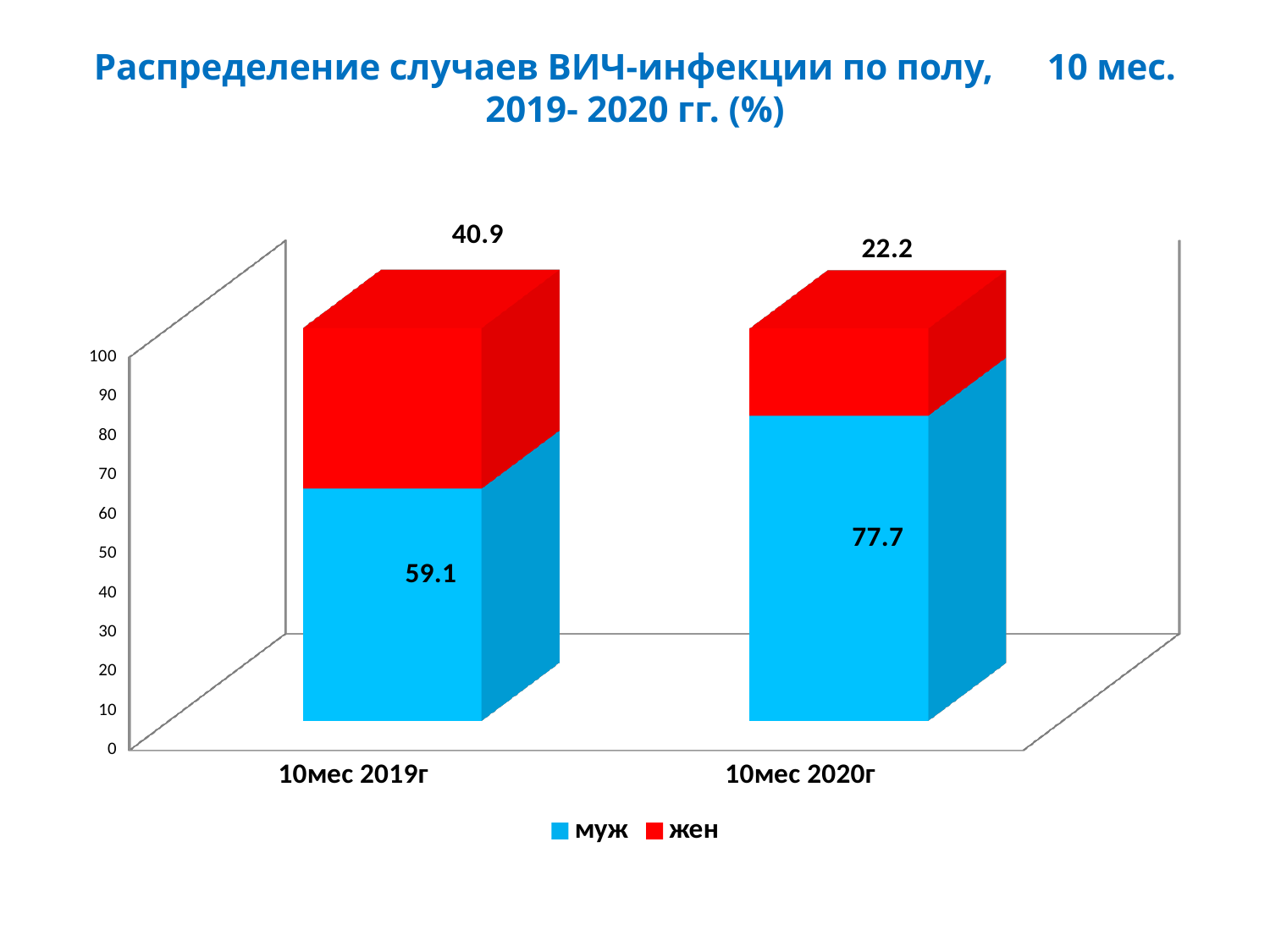
In which category is the value for жен lowest? 10мес 2020г What is the value for муж in 10мес 2020г? 77.7 How many categories are shown on the x axis? 2 What kind of chart is shown on the slide? Stacked bar chart What is the value for жен in 10мес 2020г? 22.2 Which is larger in 10мес 2019г: муж or жен? муж What is the value for жен in 10мес 2019г? 40.9 In which category is the value for муж highest? 10мес 2020г What is the difference between the муж values for 10мес 2020г and 10мес 2019г? 18.6 Which colour represents the series жен? Red What is the value for муж in 10мес 2019г? 59.1 How many series does the legend list? 2